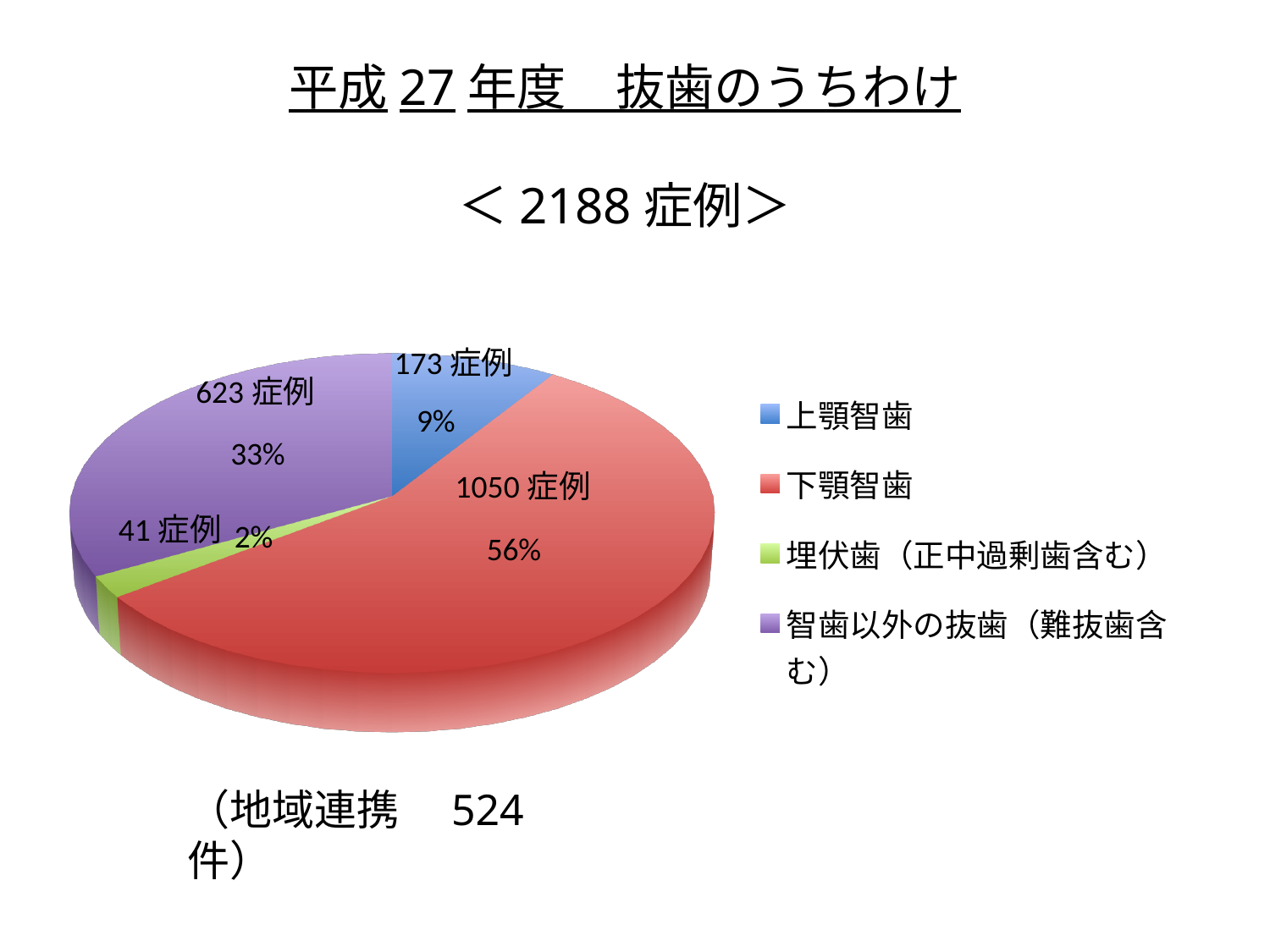
How many cases are shown for 下顎智歯? 1050 症例 Which category has the largest slice of the pie? 下顎智歯 What percentage of the pie does 埋伏歯（正中過剰歯含む） represent? 2% How many slices does the pie chart have? 4 What colour is the slice for 下顎智歯? red What type of chart is shown on the slide? pie chart What percentage of the pie does 上顎智歯 represent? 9% What is the difference in cases between 下顎智歯 and 智歯以外の抜歯（難抜歯含む）? 427 症例 How many cases are shown for 智歯以外の抜歯（難抜歯含む）? 623 症例 Which category has the smallest slice of the pie? 埋伏歯（正中過剰歯含む） How many entries does the legend list? 4 Which has more cases, 上顎智歯 or 智歯以外の抜歯（難抜歯含む）? 智歯以外の抜歯（難抜歯含む）